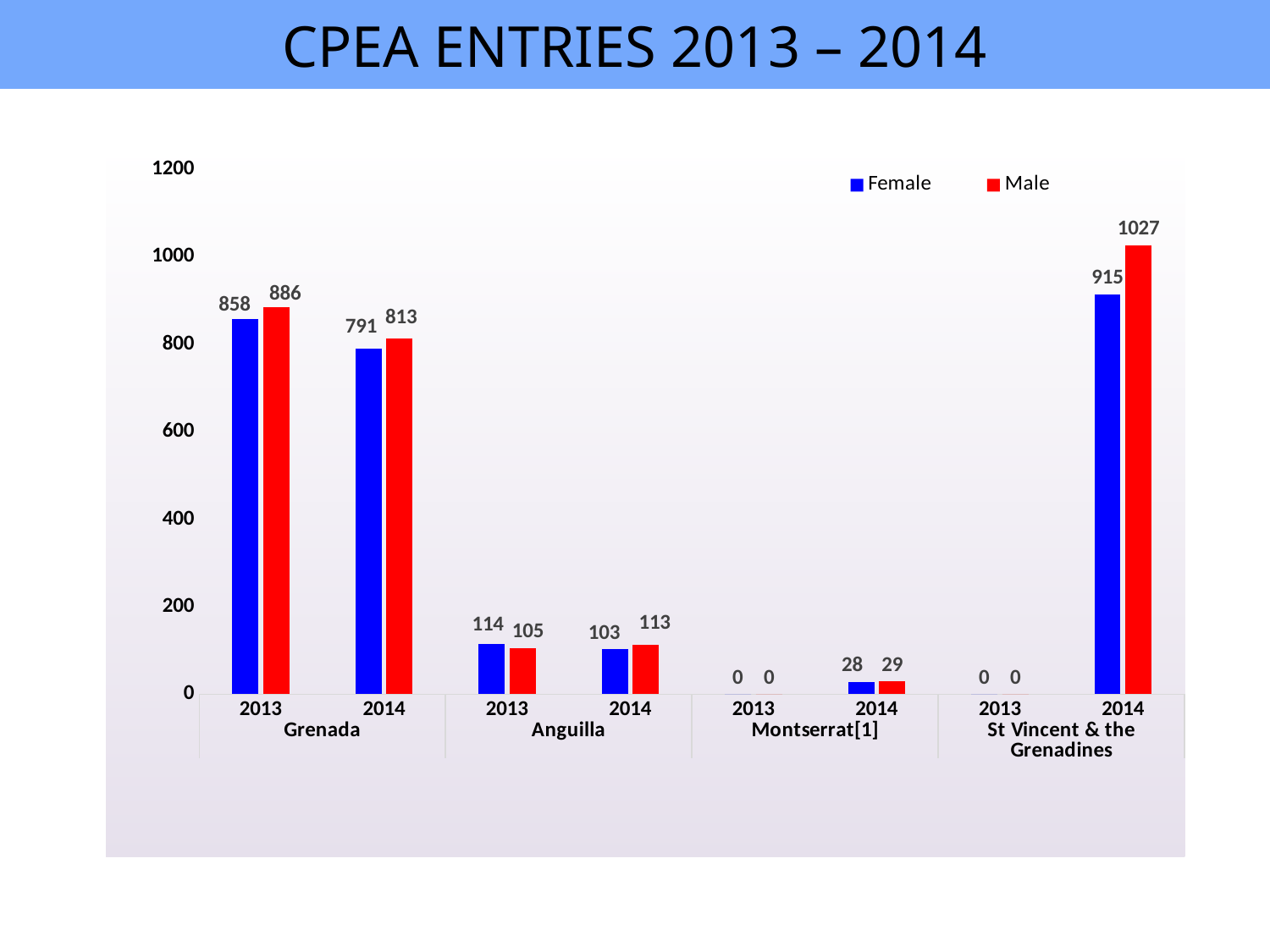
What is the difference between the Female values for Grenada in 2013 and 2014? 67 What is the Female value for Anguilla in 2014? 103 Which country and year has the highest Male value? St Vincent & the Grenadines 2014 What is the Female value for Grenada in 2013? 858 What is the Male value for St Vincent & the Grenadines in 2014? 1027 What kind of chart is shown on the slide? Bar chart How many series does the legend list? 2 What colour represents the Male series? Red What is the Male value for Montserrat[1] in 2014? 29 Which is larger for Anguilla in 2013, the Female value or the Male value? Female What is the difference between the Male and Female values for Grenada in 2014? 22 Is the Female value for St Vincent & the Grenadines in 2014 greater or less than 800? greater